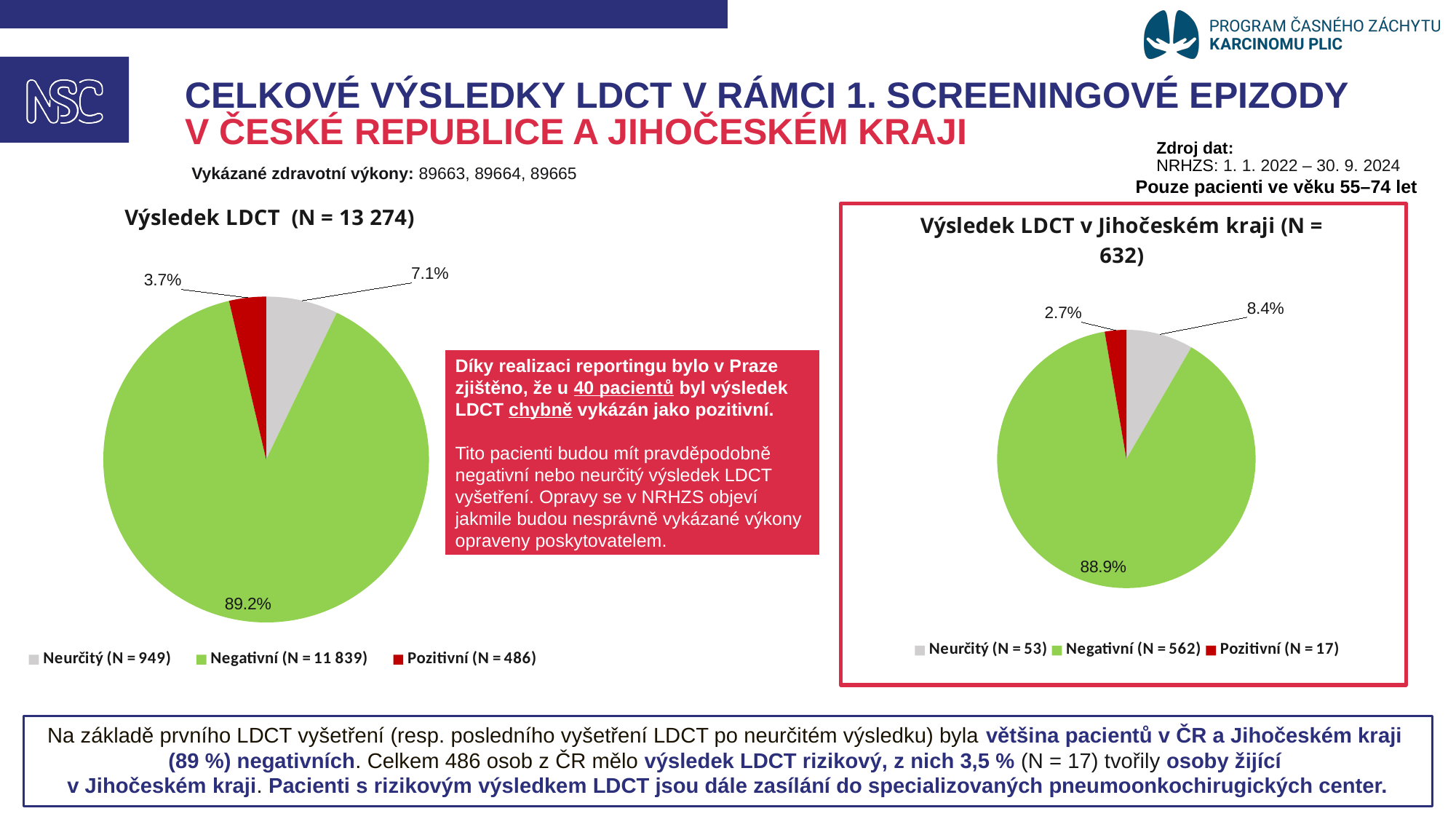
In the 'Výsledek LDCT v Jihočeském kraji (N = 632)' chart, what colour is the Pozitivní slice? red In the 'Výsledek LDCT v Jihočeském kraji (N = 632)' chart, what share of the pie is Neurčitý? 8.4% In the 'Výsledek LDCT (N = 13 274)' chart, what share of the pie is Neurčitý? 7.1% In the 'Výsledek LDCT (N = 13 274)' chart, what share of the pie is Pozitivní? 3.7% In the 'Výsledek LDCT v Jihočeském kraji (N = 632)' chart, which category has the largest slice? Negativní In the 'Výsledek LDCT (N = 13 274)' chart, what is the difference in percentage points between the Neurčitý and Pozitivní slices? 3.4 In the 'Výsledek LDCT (N = 13 274)' chart, how many categories does the legend list? 3 What kind of chart is the 'Výsledek LDCT (N = 13 274)' chart? pie chart In the 'Výsledek LDCT v Jihočeském kraji (N = 632)' chart, is the Neurčitý slice or the Pozitivní slice larger? Neurčitý In the 'Výsledek LDCT (N = 13 274)' chart, which category has the smallest slice? Pozitivní